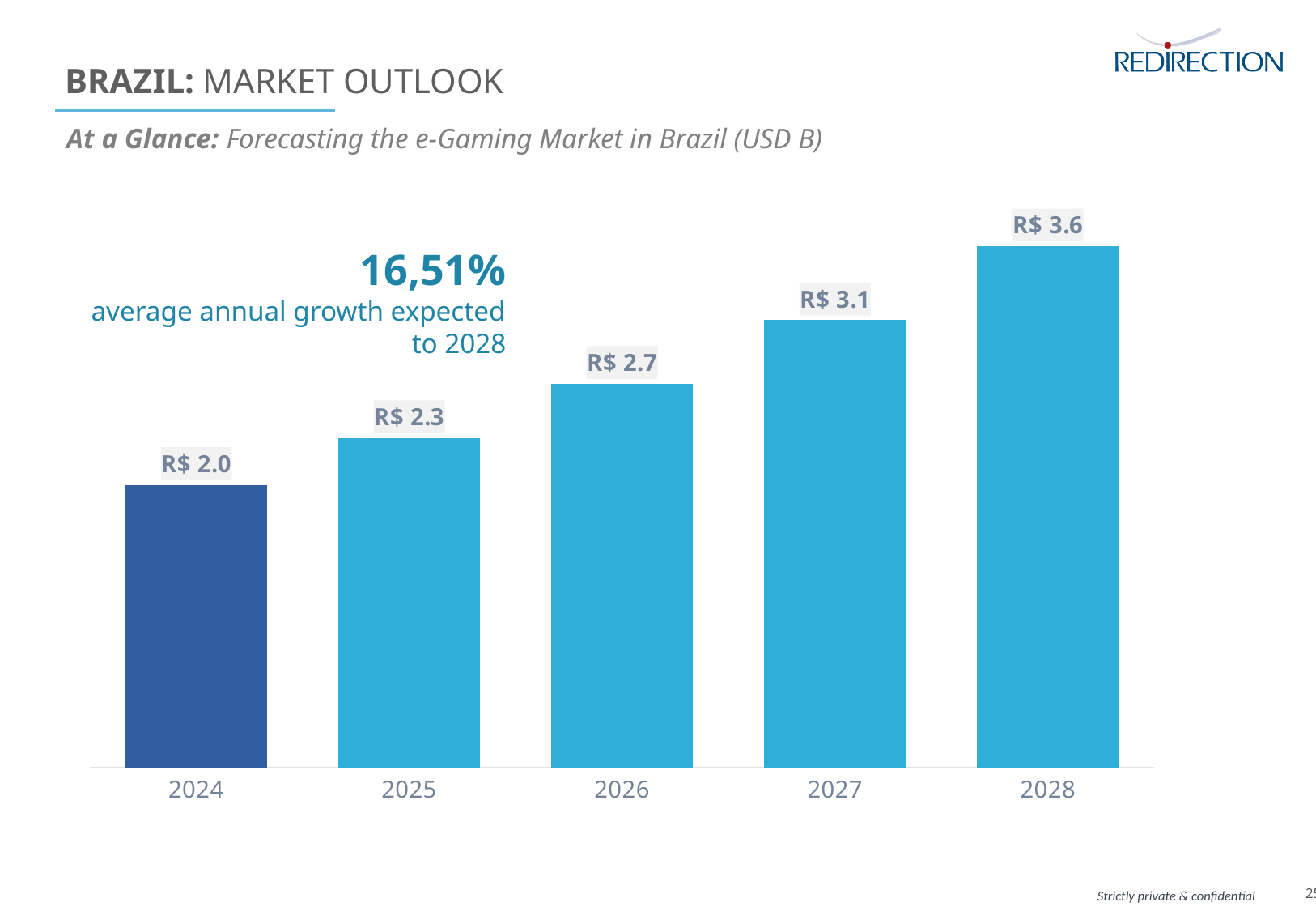
How many years are shown on the chart? 5 What is the value for 2026? R$ 2.7 What is the value for 2028? R$ 3.6 What is the difference between the values for 2028 and 2024? R$ 1.6 What is the value for 2024? R$ 2.0 Do the values rise or fall from 2024 to 2028? Rise What kind of chart is shown? Bar chart What average annual growth rate to 2028 is stated on the slide? 16,51% Which year has the lowest value? 2024 Which is larger, the value for 2025 or the value for 2027? 2027 Which year has the highest value? 2028 What is the difference between the values for 2027 and 2025? R$ 0.8